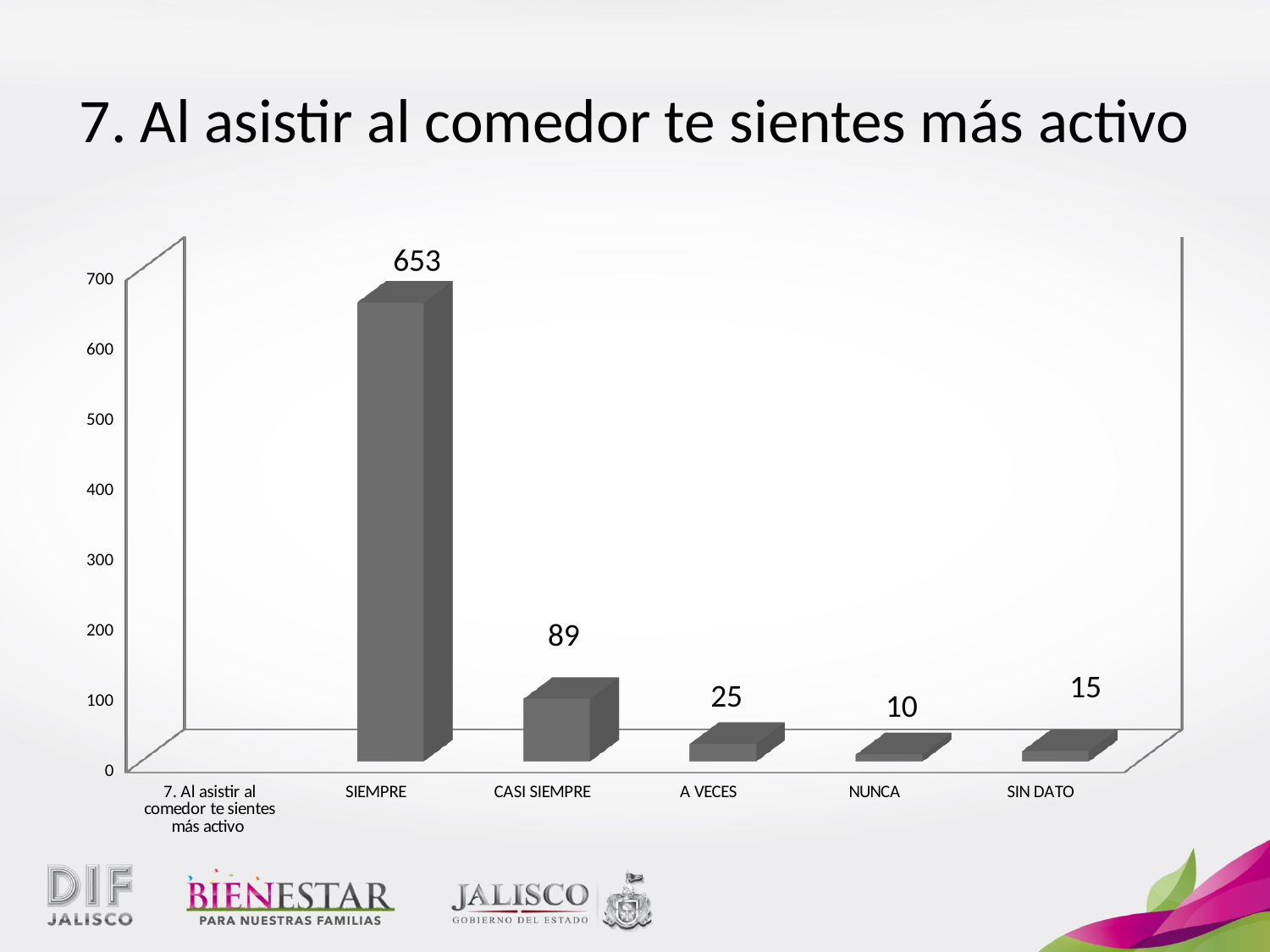
What is the value for NUNCA? 10 What is the value for A VECES? 25 Which is larger, the value for SIN DATO or the value for NUNCA? SIN DATO What is the value for CASI SIEMPRE? 89 How many bars are plotted in the chart? 5 What is the value for SIEMPRE? 653 Is the value for CASI SIEMPRE greater or less than 100? less What is the difference between the values for SIEMPRE and CASI SIEMPRE? 564 What is the value for SIN DATO? 15 Which category has the lowest value? NUNCA Which category has the highest value? SIEMPRE What kind of chart is shown on the slide? bar chart